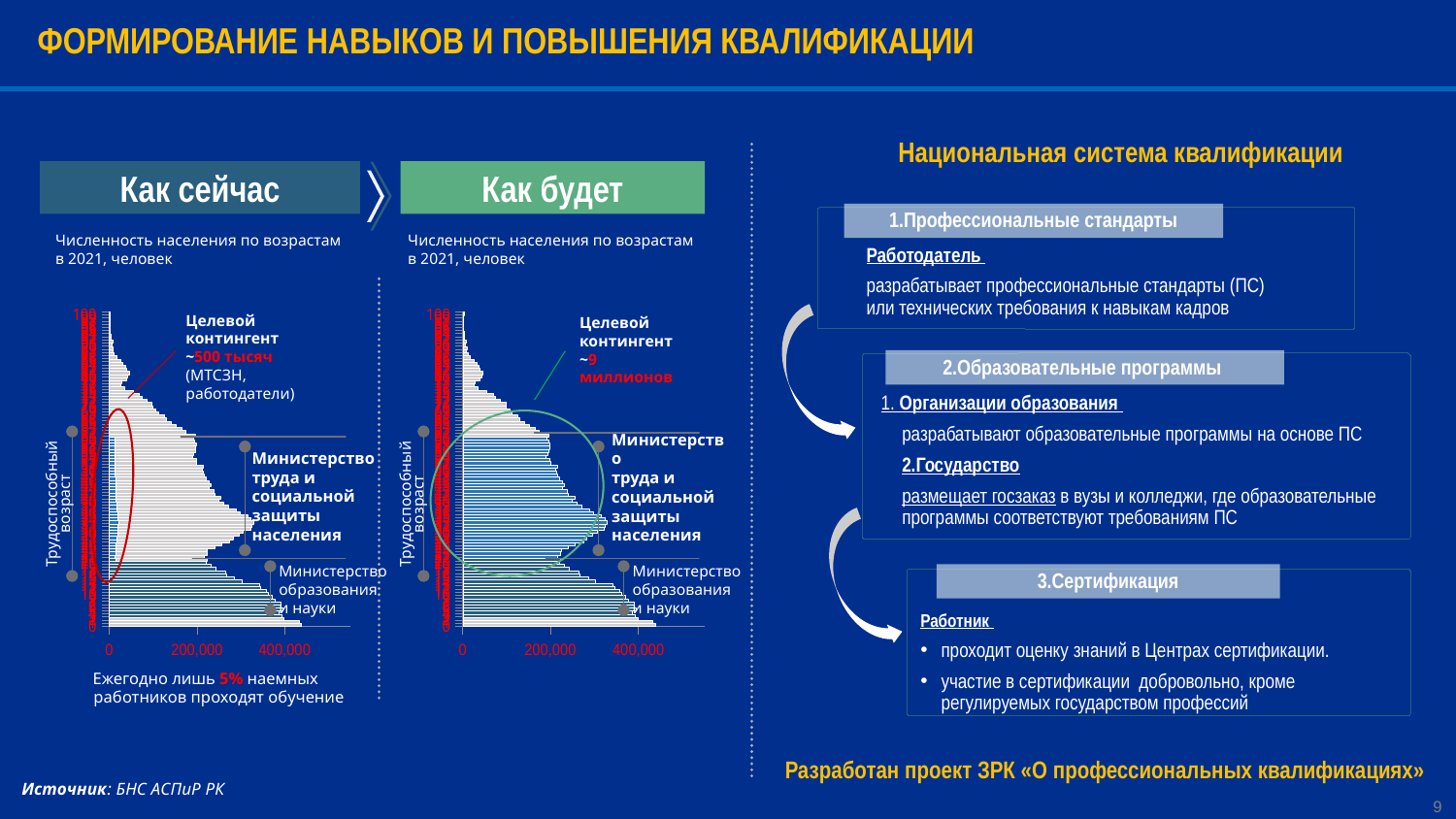
In the chart under "Как будет", do the bars generally get longer or shorter as age increases toward the top of the chart? shorter What is the largest value labelled on the horizontal axis of the chart under "Как сейчас"? 400,000 According to the note below the chart under "Как сейчас", what share of hired workers undergo training each year? 5% According to the annotation on the chart under "Как сейчас", what is the size of the target contingent (Целевой контингент)? ~500 тысяч In the chart under "Как сейчас", do the bars generally get longer or shorter as age increases toward the top of the chart? shorter What is the label on the vertical axis of the chart under "Как сейчас"? Трудоспособный возраст What kind of chart is shown under "Как будет"? bar chart How many charts are shown on the slide? 2 According to the annotation on the chart under "Как будет", what is the size of the target contingent (Целевой контингент)? ~9 миллионов What kind of chart is shown under "Как сейчас"? bar chart What is the title of the chart under "Как сейчас"? Численность населения по возрастам в 2021, человек